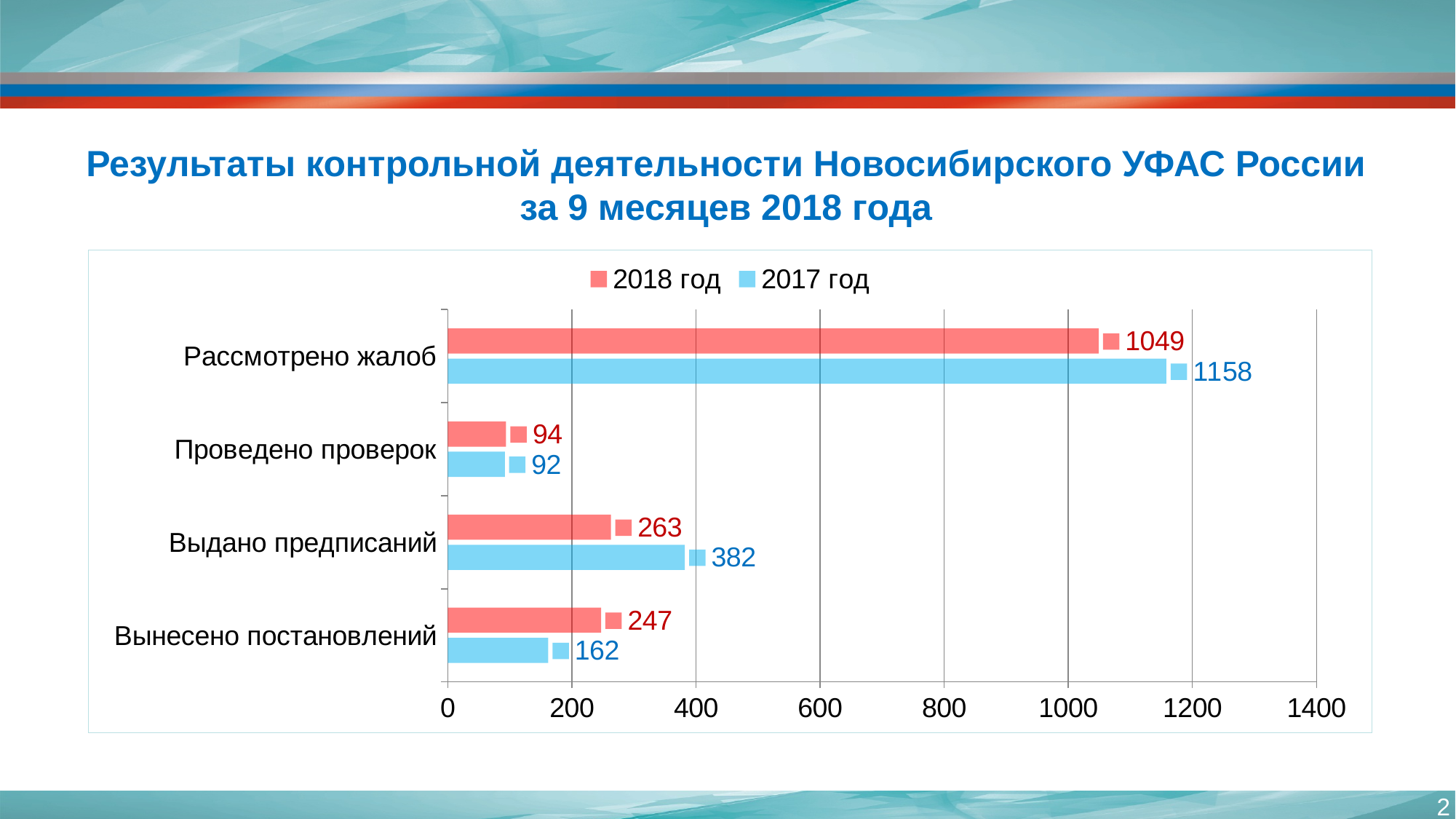
What is the difference between the 2017 год and 2018 год values for "Рассмотрено жалоб"? 109 Which category has the lowest value in the 2018 год series? Проведено проверок Which category has the highest value in the 2017 год series? Рассмотрено жалоб What is the value for "Рассмотрено жалоб" in the 2018 год series? 1049 What is the value for "Вынесено постановлений" in the 2018 год series? 247 What kind of chart is shown on the slide? Bar chart How many series does the legend list? 2 For "Выдано предписаний", which series has the larger value, 2018 год or 2017 год? 2017 год Is the 2017 год value for "Рассмотрено жалоб" greater or less than 1000? greater How many categories are shown on the chart? 4 What is the difference between the 2018 год and 2017 год values for "Вынесено постановлений"? 85 What is the value for "Выдано предписаний" in the 2017 год series? 382